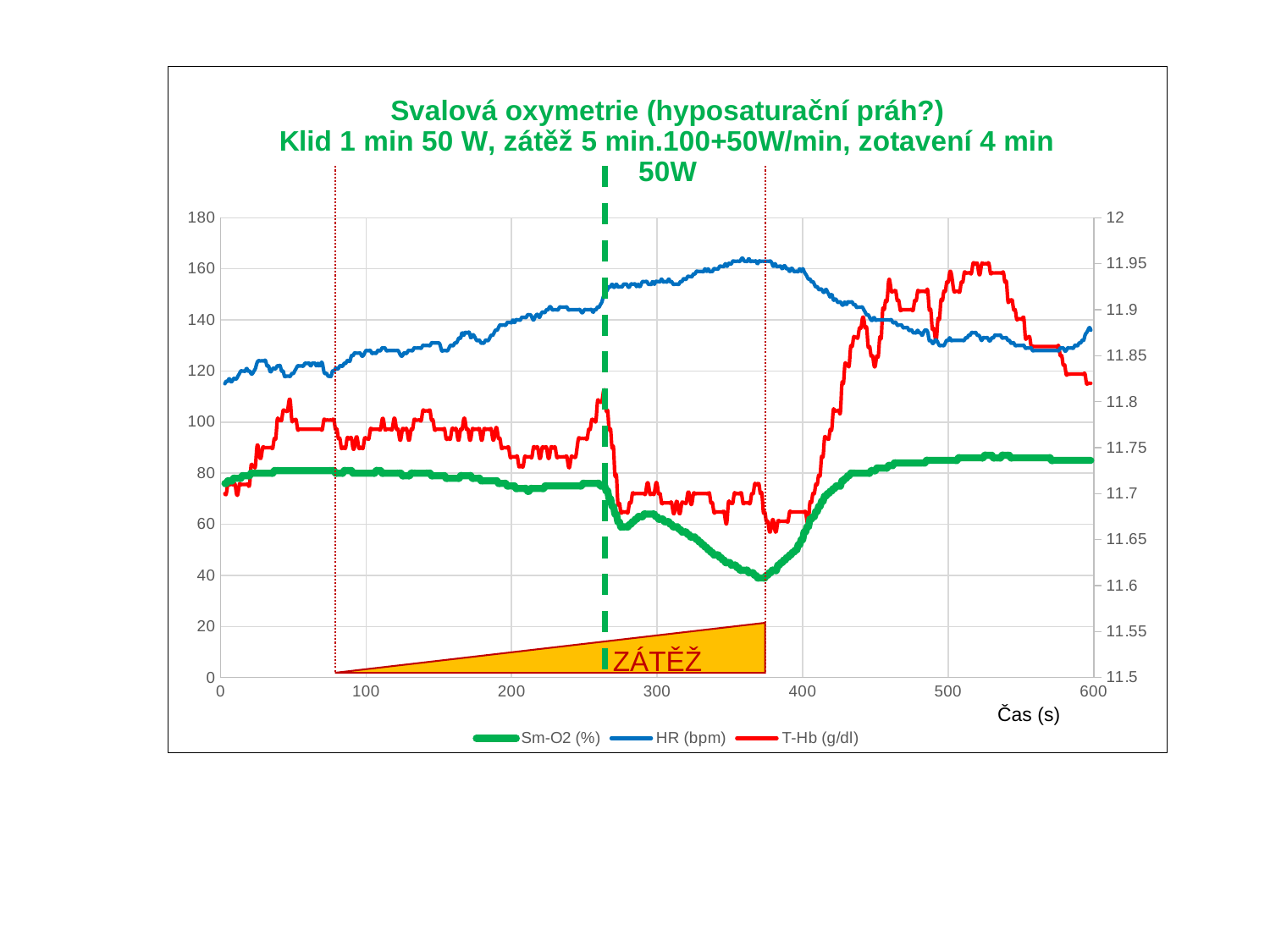
At 100 s, which is larger on the left axis: HR (bpm) or Sm-O2 (%)? HR (bpm) Does the Sm-O2 (%) line rise or fall between 300 s and 375 s? fall How many series does the legend list? 3 What is the title of the x axis? Čas (s) Is the lowest value of Sm-O2 (%), reached near 375 s, greater or less than 60? less What kind of chart is shown on the slide? line chart Does the Sm-O2 (%) line rise or fall between 400 s and 450 s? rise Is the value of Sm-O2 (%) at 100 s greater or less than 60? greater Is the value of HR (bpm) at 100 s greater or less than 120? greater Does the HR (bpm) line rise or fall between 0 s and 350 s? rise Which series is drawn in green? Sm-O2 (%)